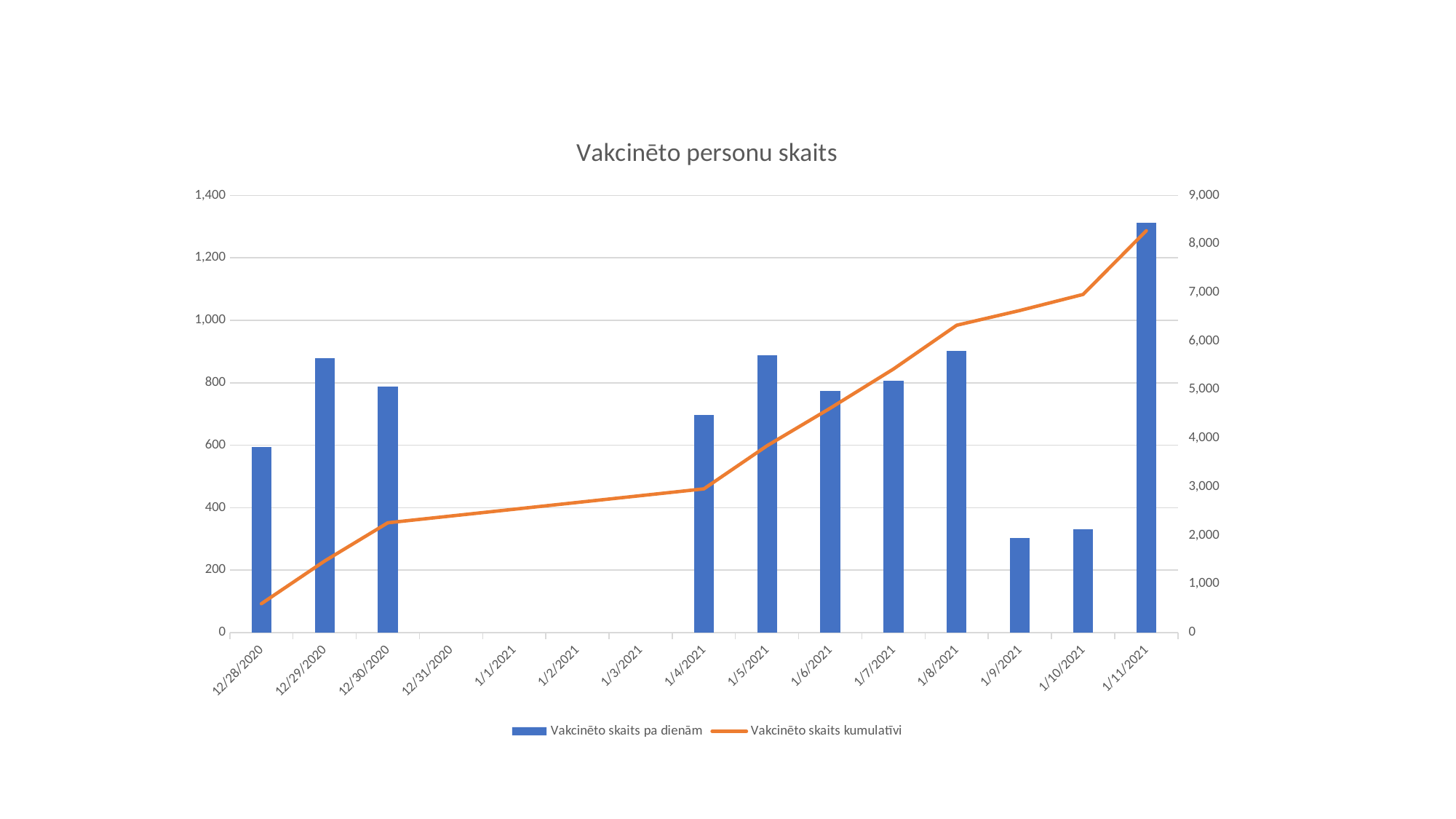
Which has the larger Vakcinēto skaits pa dienām value, 12/29/2020 or 12/30/2020? 12/29/2020 What is the title of the chart? Vakcinēto personu skaits Is the Vakcinēto skaits kumulatīvi value for 1/11/2021 greater or less than 8,000? greater Which has the larger Vakcinēto skaits pa dienām value, 1/7/2021 or 1/8/2021? 1/8/2021 What kind of chart is this? Combined bar and line chart Is the Vakcinēto skaits pa dienām value for 1/11/2021 greater or less than 1,200? greater How many dates are shown on the x axis? 15 Which date has the highest bar for Vakcinēto skaits pa dienām? 1/11/2021 Does the Vakcinēto skaits kumulatīvi line rise or fall from 12/28/2020 to 1/11/2021? rise Is the Vakcinēto skaits pa dienām value for 12/29/2020 greater or less than 800? greater How many series does the legend list? 2